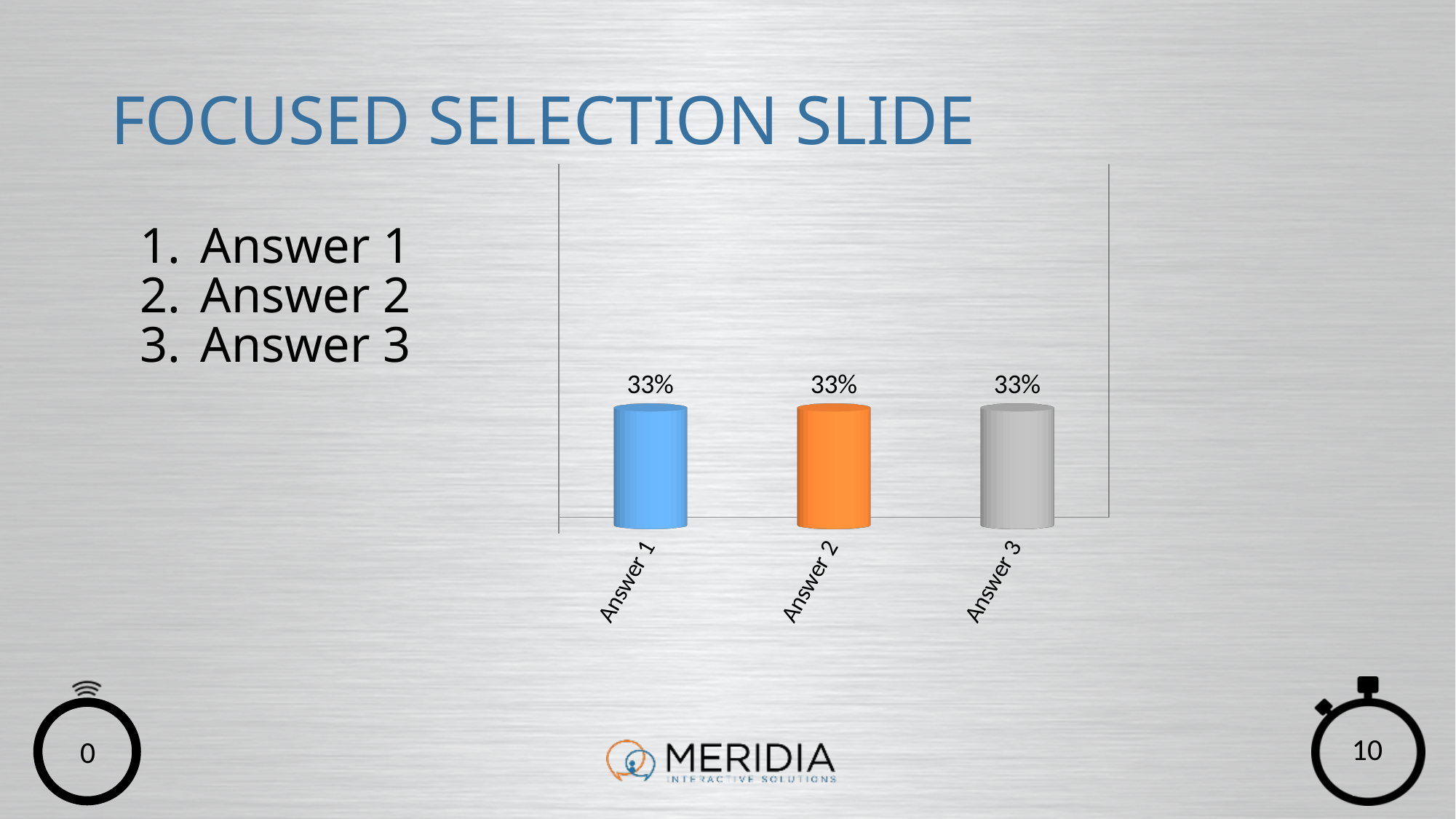
What is the value for Answer 2? 33% What colour is the bar for Answer 2? orange What is the label of the first category on the x axis? Answer 1 Do the values rise, fall, or stay the same from Answer 1 to Answer 3? stay the same What is the value for Answer 1? 33% What is the value for Answer 3? 33% What kind of chart is shown on the slide? bar chart What is the difference between the values for Answer 1 and Answer 3? 0% How many categories are shown on the chart? 3